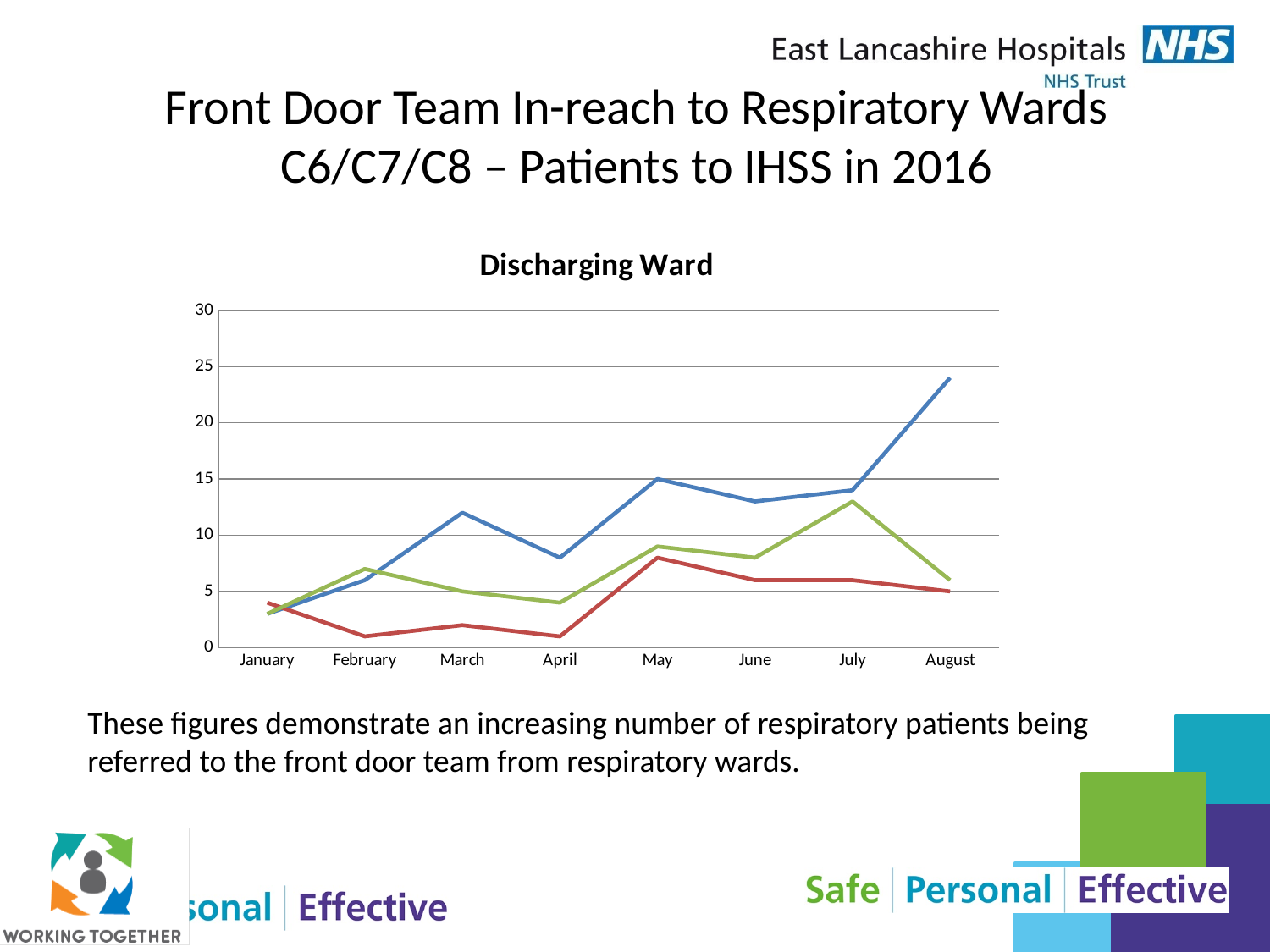
Is the value of the red line in February greater or less than 5? less In which month does the blue line reach its highest value? August Is the value of the green line in July greater or less than 10? greater What is the highest value shown on the y axis of the chart? 30 Does the blue line rise or fall overall from January to August? Rises In August, which line has the higher value, the blue line or the green line? Blue line What type of chart is shown on the slide? Line chart How many months are shown along the x axis of the chart? 8 How many lines are plotted on the chart? 3 What is the title of the chart? Discharging Ward Is the value of the blue line in August greater or less than 20? greater In which month is the blue line at its lowest value? January